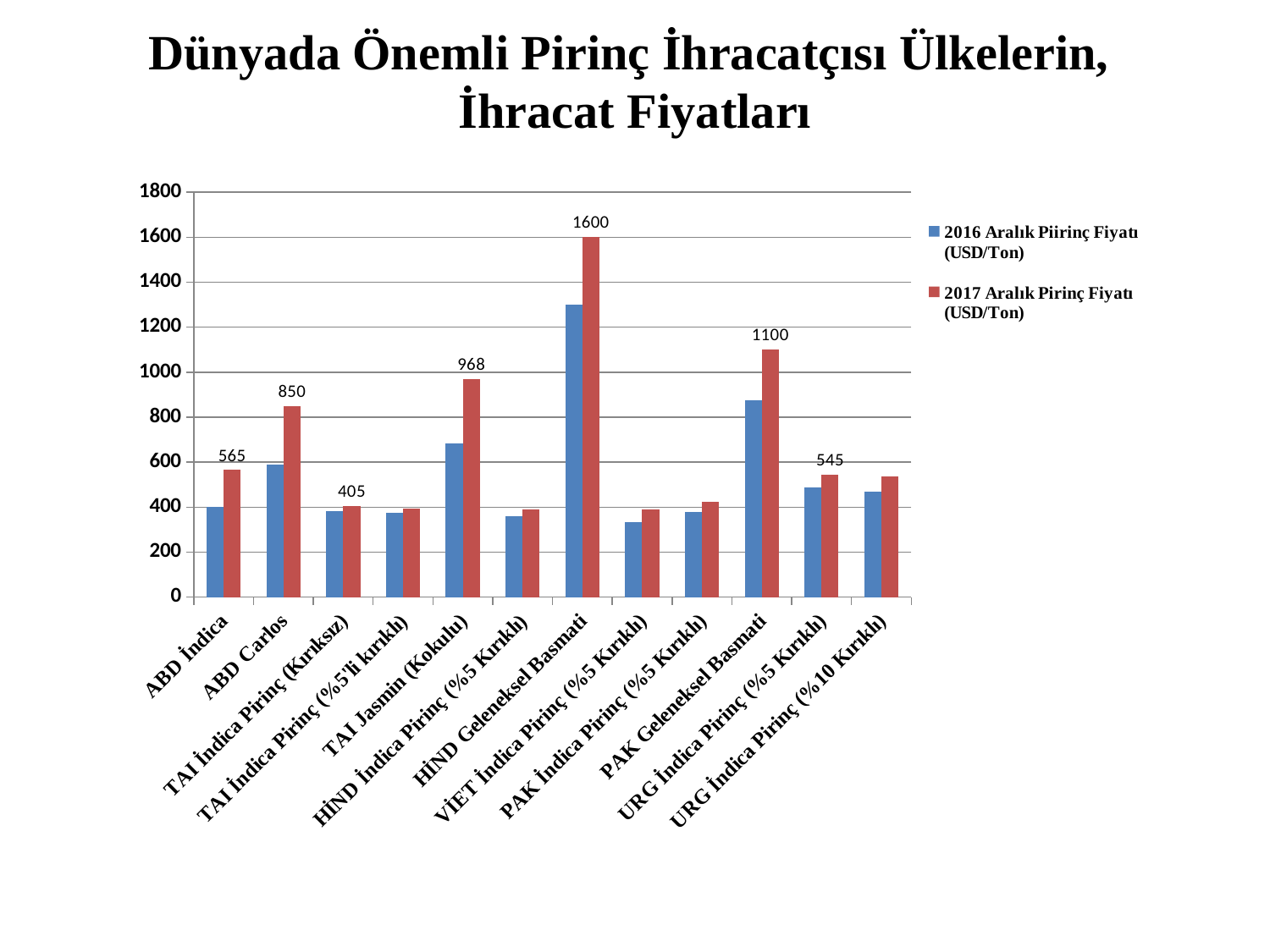
Is the 2016 Aralık Piirinç Fiyatı (USD/Ton) for VİET İndica Pirinç (%5 Kırıklı) greater or less than 400? less What is the 2017 Aralık Pirinç Fiyatı (USD/Ton) for TAI Jasmin (Kokulu)? 968 What is the difference between the 2017 price of ABD Carlos and ABD İndica? 285 Is the 2016 Aralık Piirinç Fiyatı (USD/Ton) for HİND Geleneksel Basmati greater or less than 1200? greater Which is larger, the 2017 price of TAI Jasmin (Kokulu) or the 2017 price of ABD Carlos? TAI Jasmin (Kokulu) What is the 2017 Aralık Pirinç Fiyatı (USD/Ton) for URG İndica Pirinç (%5 Kırıklı)? 545 How many categories are shown on the x axis of the chart? 12 What is the 2017 Aralık Pirinç Fiyatı (USD/Ton) for ABD Carlos? 850 Which category has the highest 2017 Aralık Pirinç Fiyatı (USD/Ton)? HİND Geleneksel Basmati How many series does the legend list? 2 What is the 2017 Aralık Pirinç Fiyatı (USD/Ton) for HİND Geleneksel Basmati? 1600 What is the difference between the 2017 price of HİND Geleneksel Basmati and PAK Geleneksel Basmati? 500